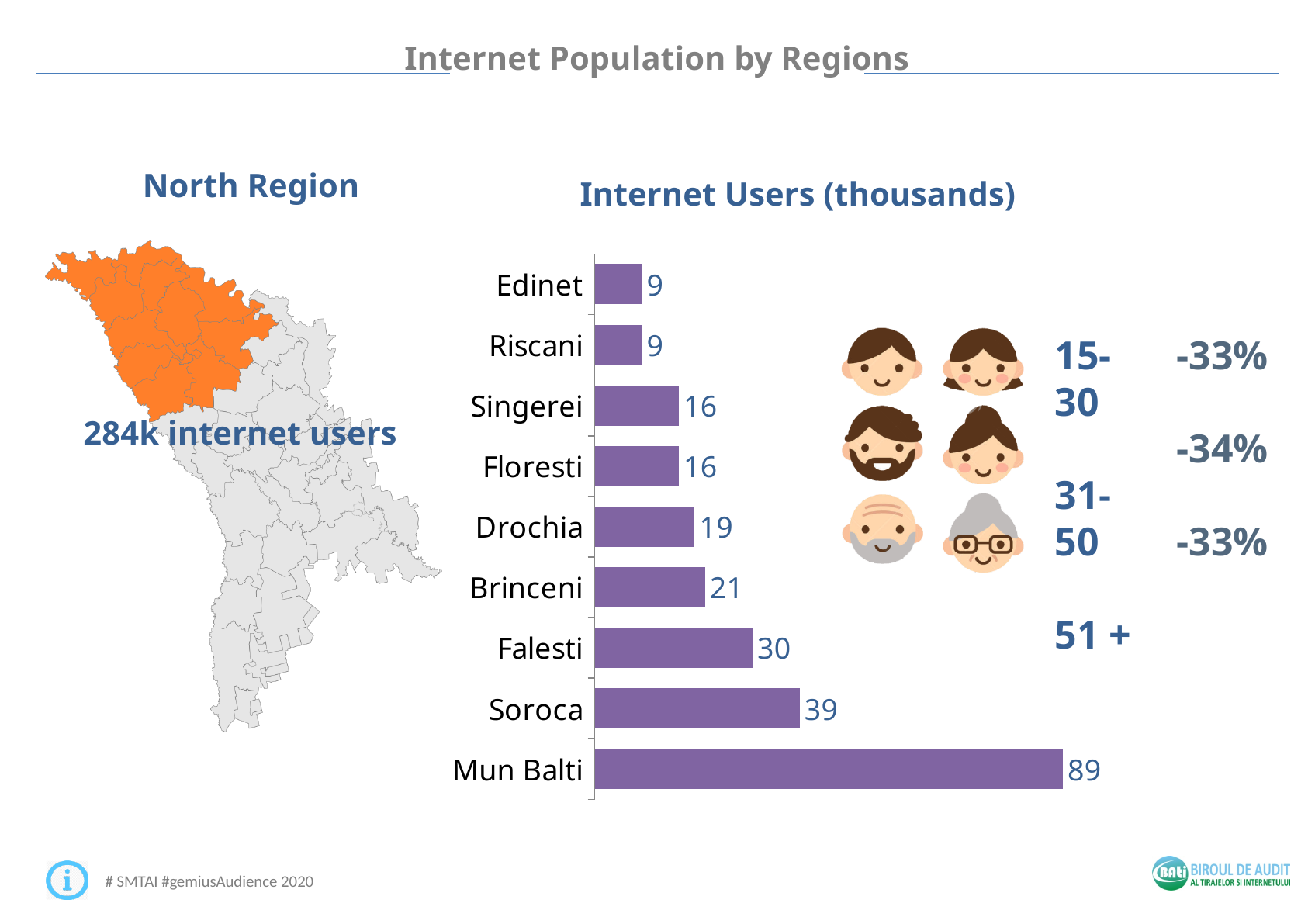
How many categories are shown in the Internet Users (thousands) chart? 9 Which category has the highest value in the Internet Users (thousands) chart? Mun Balti What is the difference between the values for Mun Balti and Soroca in the Internet Users (thousands) chart? 50 What is the value for Mun Balti in the Internet Users (thousands) chart? 89 What is the value for Soroca in the Internet Users (thousands) chart? 39 What is the value for Drochia in the Internet Users (thousands) chart? 19 What is the title of the chart on the slide? Internet Users (thousands) What kind of chart is the Internet Users (thousands) chart? bar chart Which is larger in the Internet Users (thousands) chart, Falesti or Brinceni? Falesti What colour are the bars in the Internet Users (thousands) chart? purple What is the value for Brinceni in the Internet Users (thousands) chart? 21 What is the difference between the values for Falesti and Drochia in the Internet Users (thousands) chart? 11